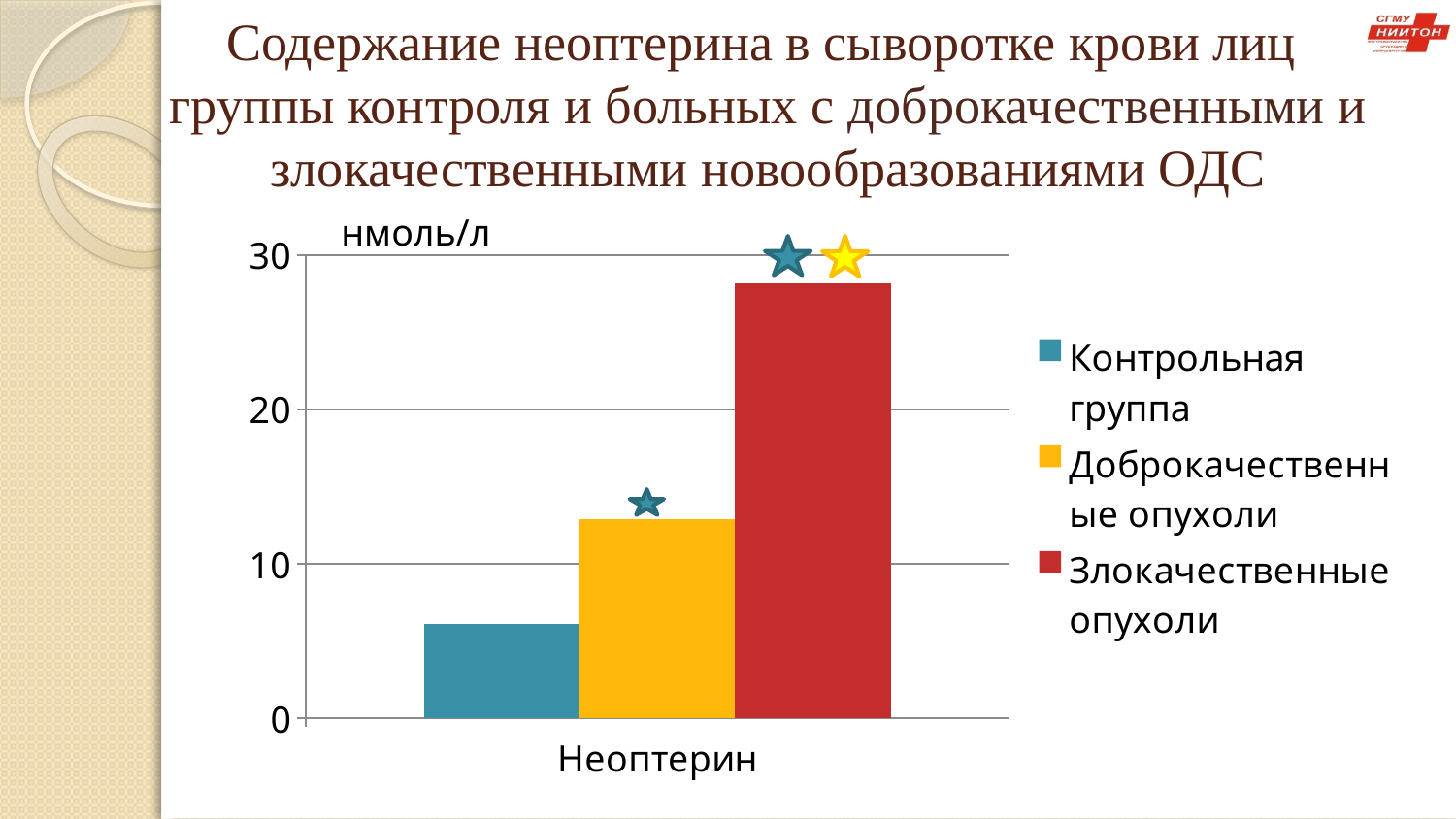
Which is larger for Неоптерин: Контрольная группа or Доброкачественные опухоли? Доброкачественные опухоли What unit is shown above the y axis of the chart? нмоль/л What kind of chart is shown on the slide? bar chart Which series has the lowest value for Неоптерин? Контрольная группа Is the value for Доброкачественные опухоли greater or less than 10? greater Is the value for Злокачественные опухоли greater or less than 20? greater What colour is the bar for Злокачественные опухоли? red Is the value for Контрольная группа greater or less than 10? less Which series has the highest value for Неоптерин? Злокачественные опухоли How many categories are shown on the x axis? 1 How many series does the legend list? 3